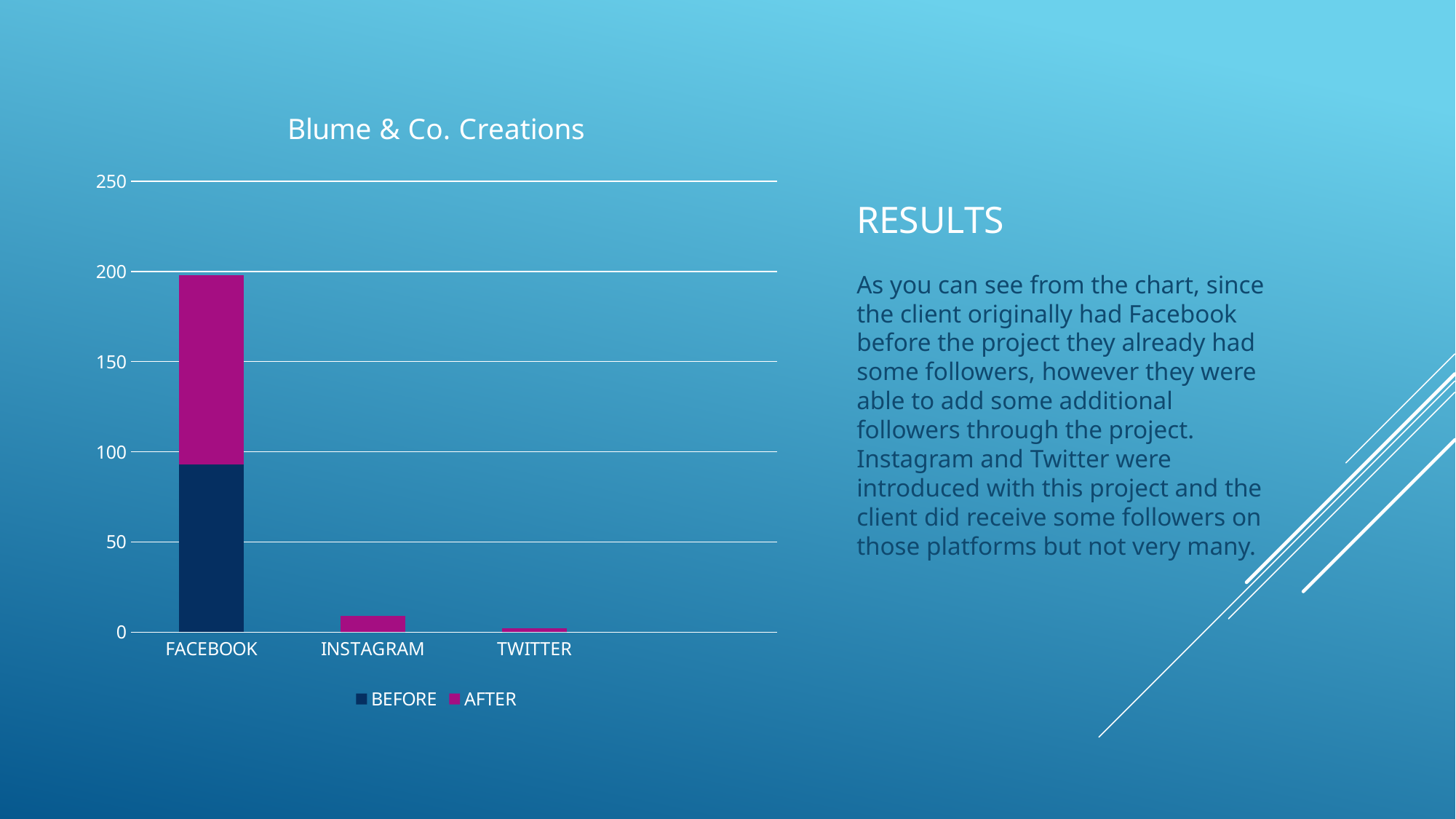
Which platform has the lowest total bar? TWITTER Which platform has the highest total bar? FACEBOOK Is the BEFORE value for FACEBOOK greater or less than 50? greater What kind of chart is shown on the slide? bar chart Which series are listed in the chart legend? BEFORE and AFTER What is the title of the chart? Blume & Co. Creations How many series does the chart legend list? 2 Is the total value for FACEBOOK greater or less than 150? greater Is the total value for INSTAGRAM greater or less than 50? less How many platforms (categories) are shown on the x axis? 3 Which has a larger total bar, INSTAGRAM or TWITTER? INSTAGRAM